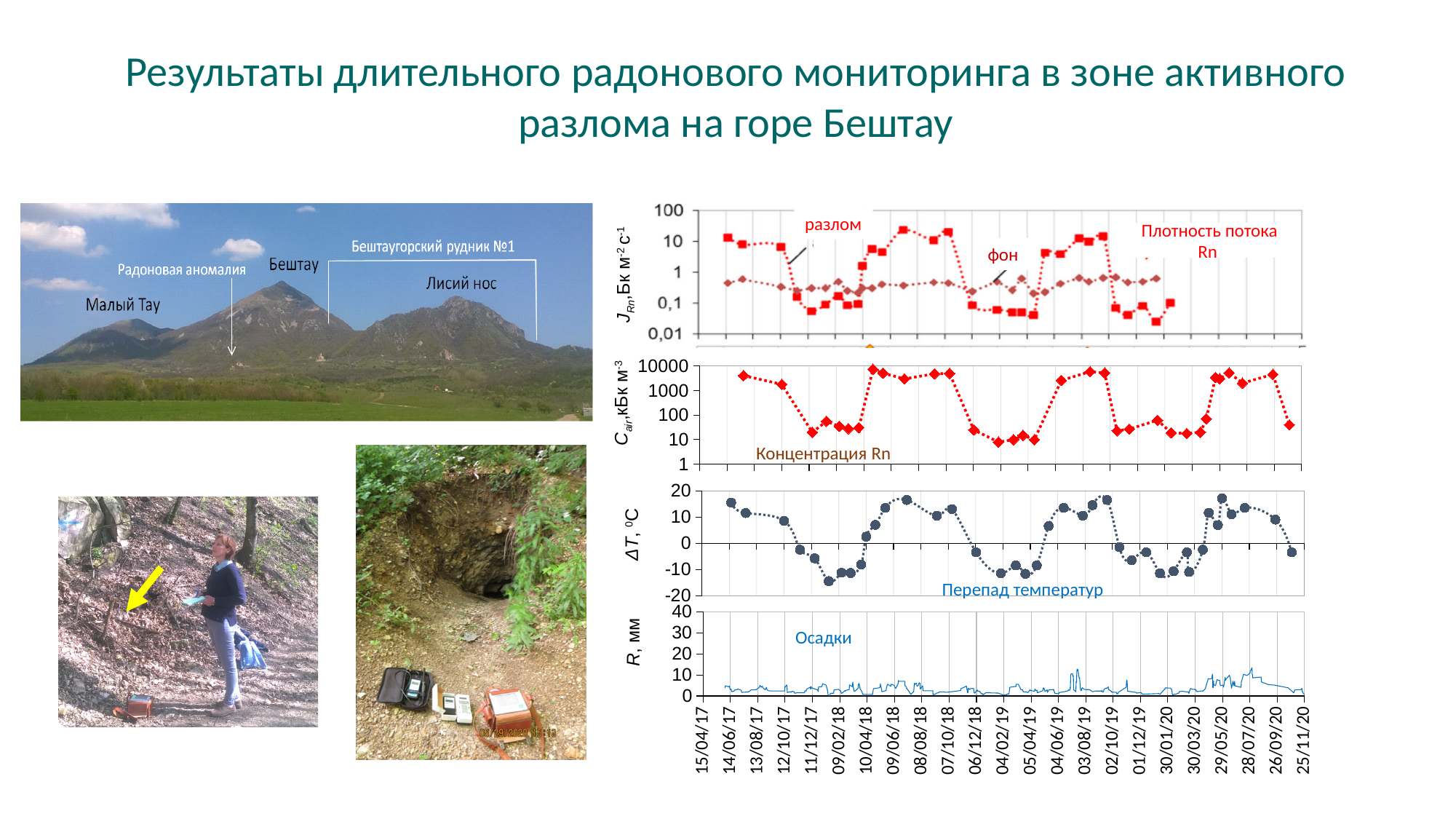
In the Плотность потока Rn chart, is the фон series at its first point greater or less than 1? less In the Перепад температур chart, is the lowest value greater or less than -10? less What kind of chart is the Плотность потока Rn chart at the top right? line chart In the Осадки chart, is the highest value greater or less than 20? less What is the last date label on the shared x axis of the charts? 25/11/20 How many stacked charts are shown on the right side of the slide? 4 How many series are plotted in the Плотность потока Rn chart? 2 In the Концентрация Rn chart, do the values rise or fall between 14/06/17 and 11/12/17? fall